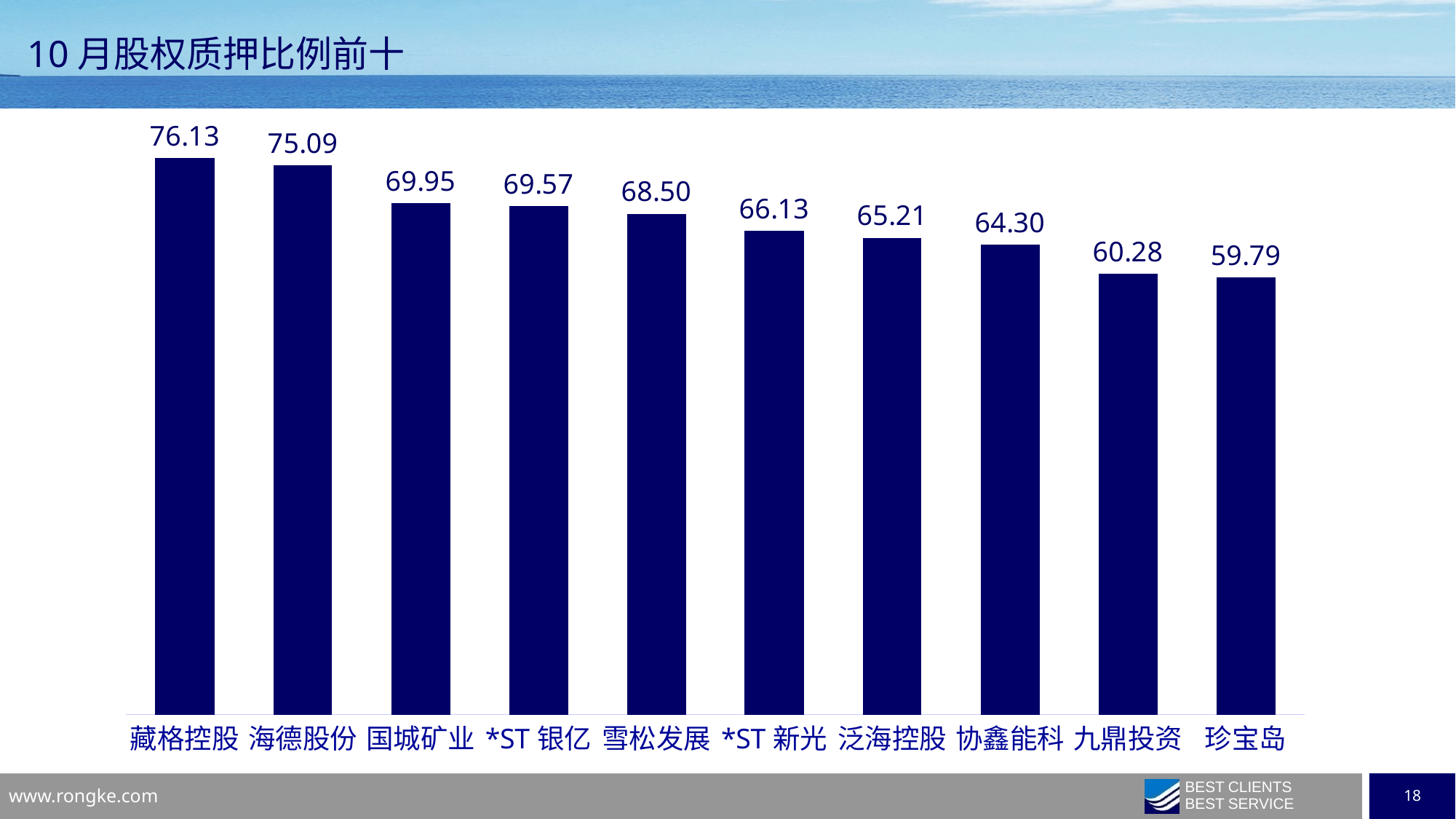
Which category has the highest value? 藏格控股 What is the title of the slide? 10 月股权质押比例前十 What kind of chart is shown on the slide? bar chart Do the values rise or fall from left to right along the x axis? fall What is the difference between the values for 藏格控股 and 海德股份? 1.04 How many categories are shown in the chart? 10 What is the difference between the values for 国城矿业 and 珍宝岛? 10.16 Which category has the lowest value? 珍宝岛 What is the value for 藏格控股? 76.13 Which is larger, the value for *ST 新光 or the value for 泛海控股? *ST 新光 What is the value for 雪松发展? 68.50 What is the value for 九鼎投资? 60.28